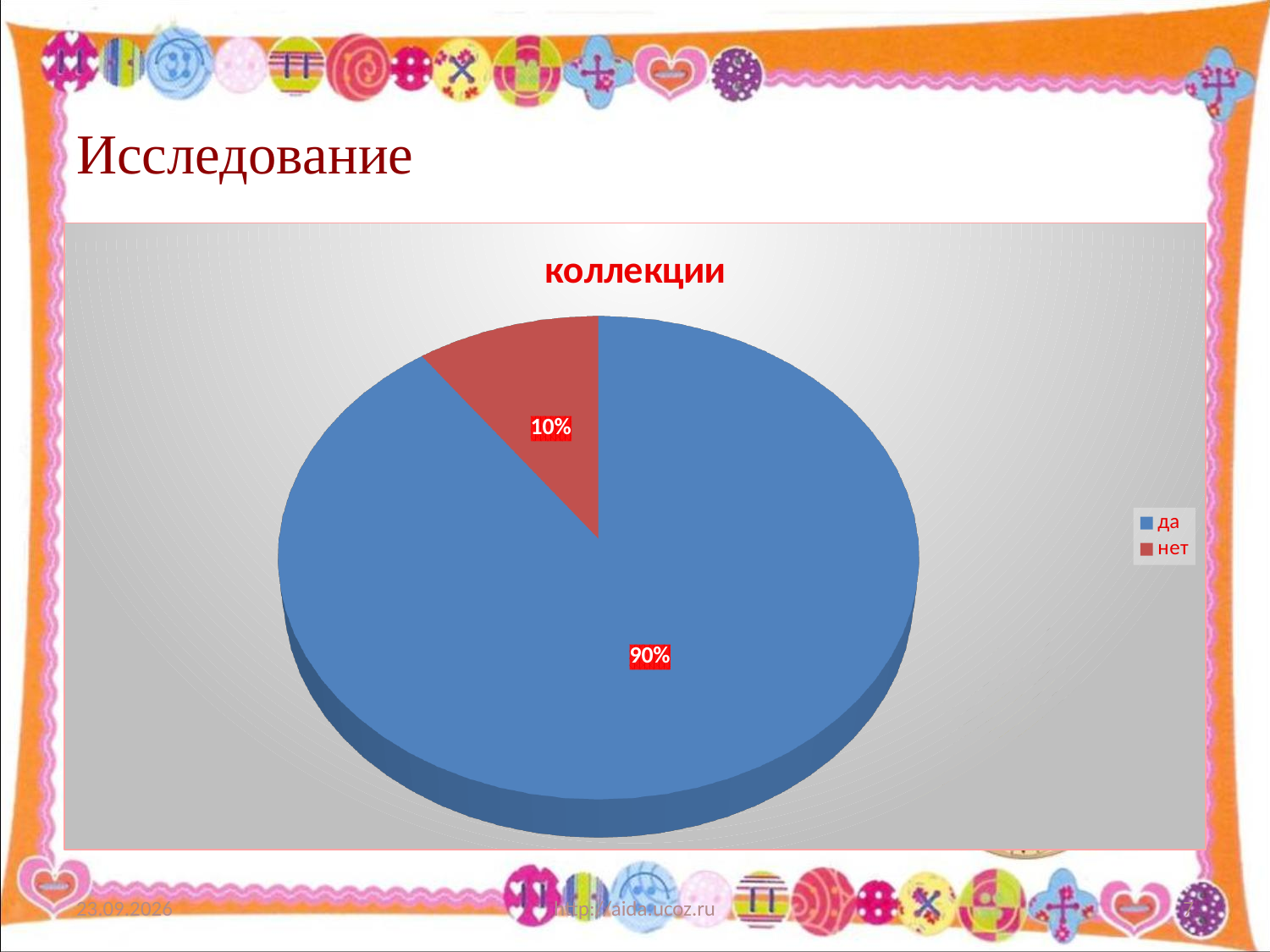
What kind of chart is shown on the slide? pie chart Which is larger, the "да" slice or the "нет" slice? да What percentage does the "да" slice show? 90% What is the difference in percentage points between the "да" and "нет" slices? 80 Which category has the largest share of the pie? да Which category has the smallest share of the pie? нет How many entries does the legend list? 2 What share of the pie does the "да" slice represent? 90% What percentage does the "нет" slice show? 10% What colour is the "нет" slice? red How many slices does the pie chart have? 2 What is the title of the chart? коллекции